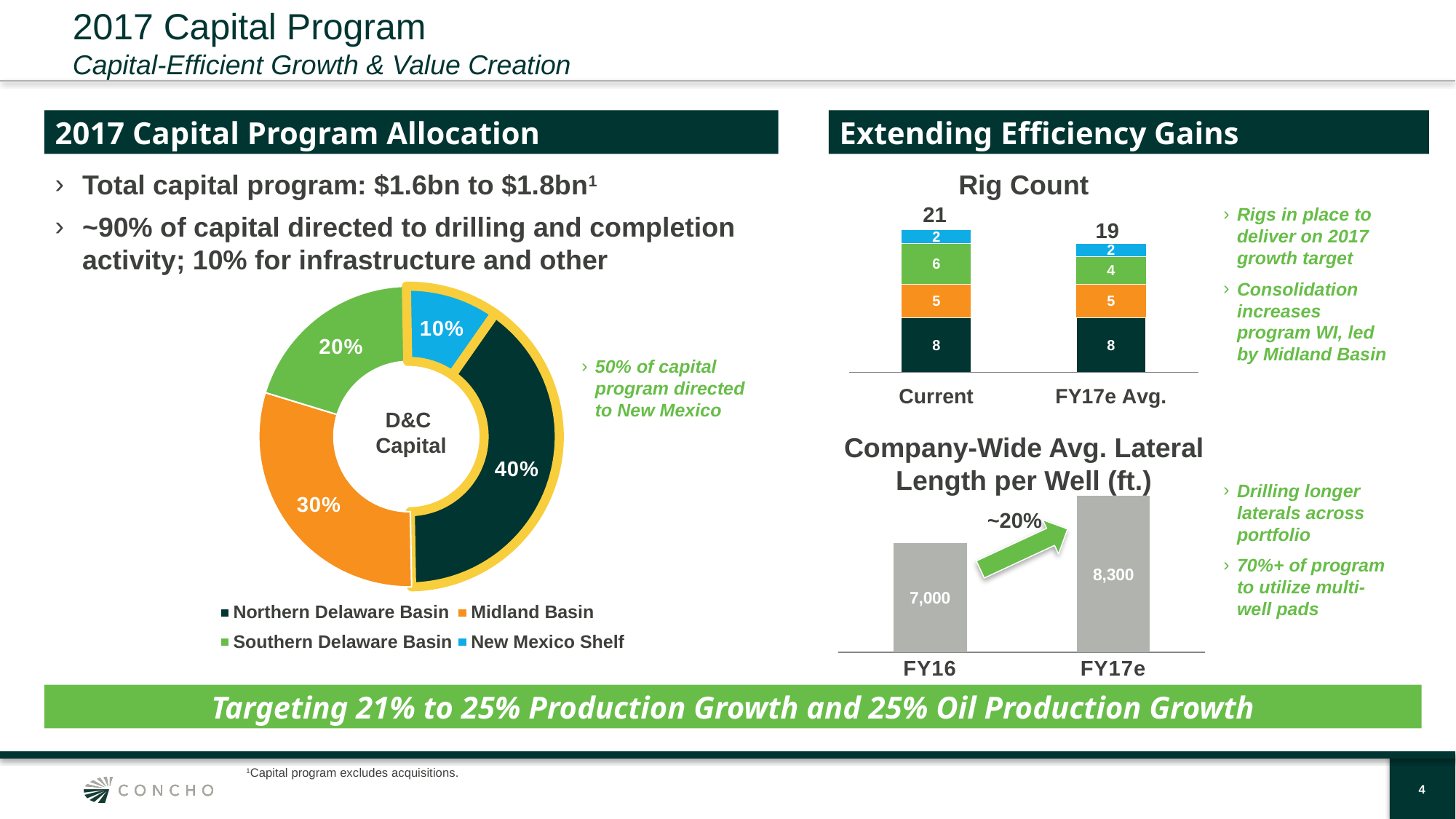
In the D&C Capital donut chart, which basin has the largest share? Northern Delaware Basin In the Company-Wide Avg. Lateral Length per Well chart, what is the value for FY16? 7,000 In the Rig Count chart, what is the value of the bottom (dark green) segment of the FY17e Avg. bar? 8 In the Rig Count chart, what is the total rig count for Current? 21 In the Rig Count chart, what is the total rig count for FY17e Avg.? 19 In the D&C Capital donut chart, what share is allocated to the Northern Delaware Basin? 40% What type of chart is the D&C Capital chart? Donut (pie) chart In the Company-Wide Avg. Lateral Length per Well chart, what is the difference between FY17e and FY16? 1,300 How many categories does the legend of the D&C Capital donut chart list? 4 In the D&C Capital donut chart, which category has the smallest share? New Mexico Shelf In the D&C Capital donut chart, what share is allocated to the New Mexico Shelf? 10% In the D&C Capital donut chart, how many percentage points larger is the Midland Basin share than the Southern Delaware Basin share? 10 percentage points